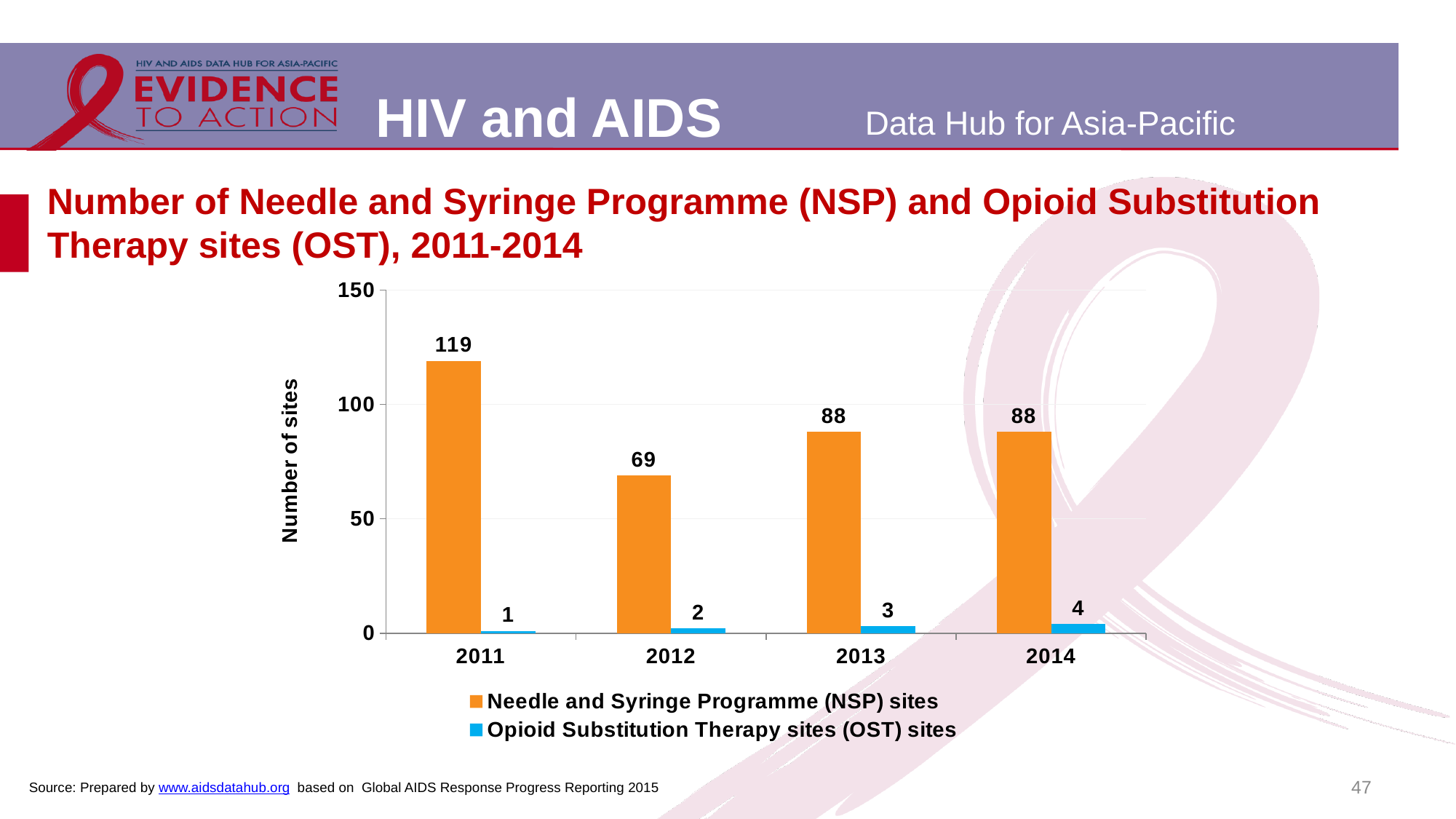
How many Opioid Substitution Therapy (OST) sites were there in 2014? 4 Is the number of NSP sites in 2013 greater or less than 100? less What kind of chart is shown on the slide? Bar chart In which year was the number of NSP sites highest? 2011 In which year was the number of NSP sites lowest? 2012 What is the difference between the number of NSP sites in 2011 and in 2012? 50 How many years are shown on the x axis? 4 Which is larger: the number of OST sites in 2013 or in 2012? 2013 How many Needle and Syringe Programme (NSP) sites were there in 2011? 119 How many series does the legend list? 2 Do the OST site values rise or fall from 2011 to 2014? Rise How many NSP sites were there in 2012? 69